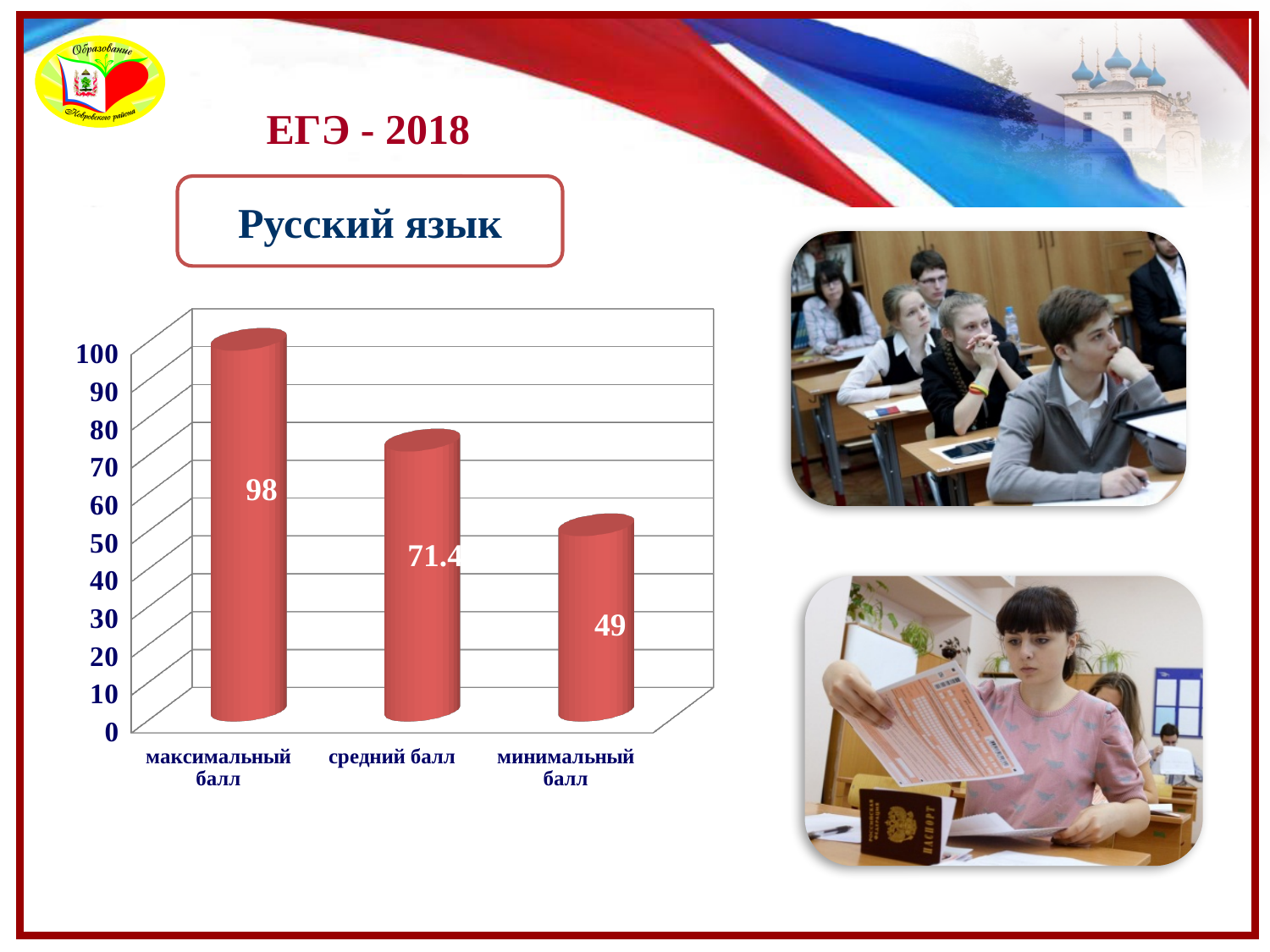
Which is larger, средний балл or минимальный балл? средний балл What is the difference between максимальный балл and средний балл? 26.6 What is the difference between максимальный балл and минимальный балл? 49 Do the values rise or fall from left to right along the x axis? fall Is the value for средний балл greater or less than 60? greater Which category has the highest value? максимальный балл What is the value for средний балл? 71.4 What is the value for максимальный балл? 98 How many categories are shown on the chart? 3 What kind of chart is shown on the slide? bar chart What is the value for минимальный балл? 49 Which category has the lowest value? минимальный балл